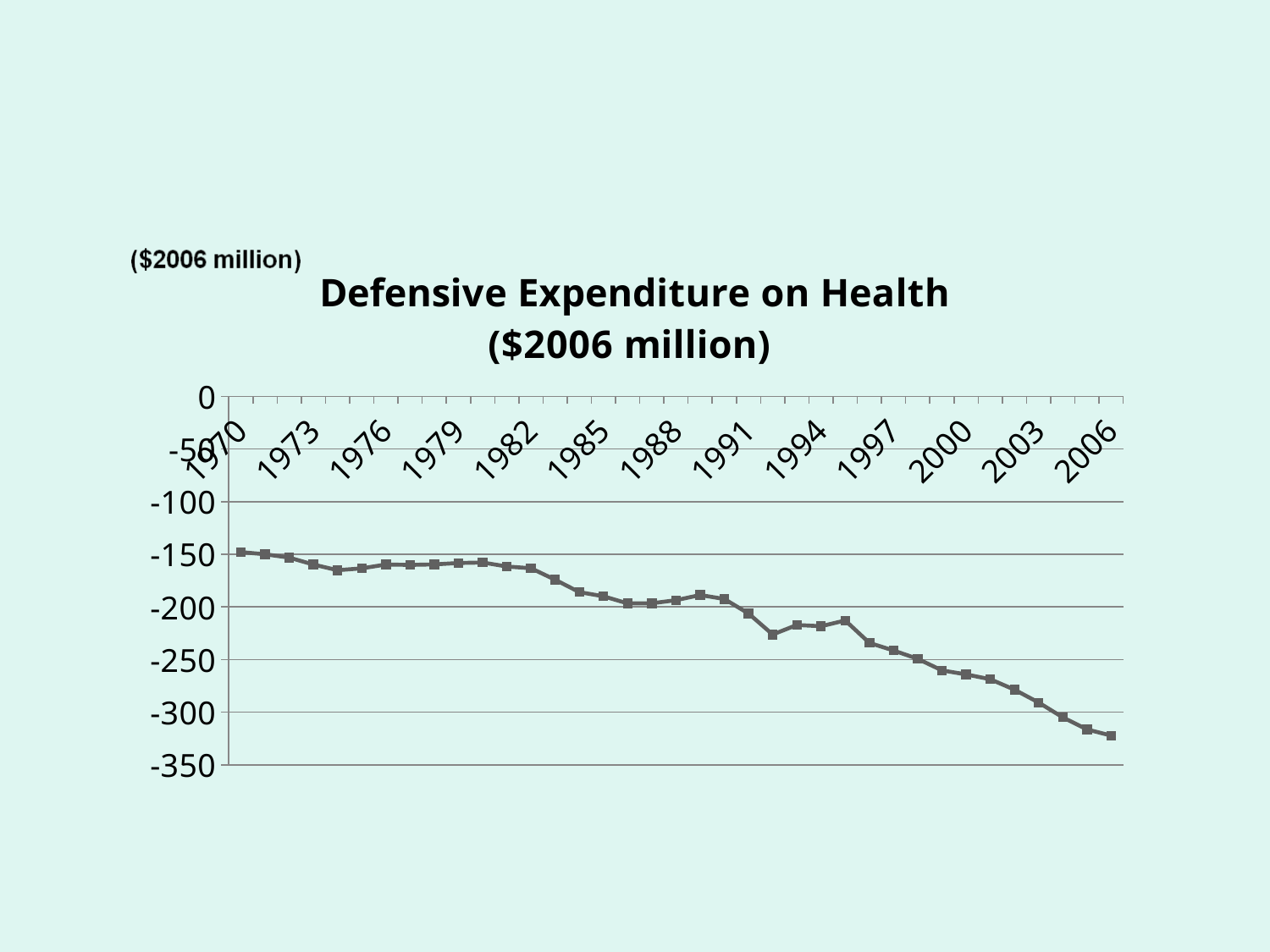
Which year has the larger value, 1994 or 2000? 1994 What kind of chart is shown on the slide? line chart What is the title of the chart? Defensive Expenditure on Health ($2006 million) Is the value for 2003 greater or less than -250? less Do the values generally rise or fall from 1970 to 2006? fall Which year has the larger value, 1976 or 1988? 1976 Which year has the lowest value on the chart? 2006 How many year labels are shown on the x axis? 13 Is the value for 2006 greater or less than -300? less Is the value for 1997 greater or less than -250? greater